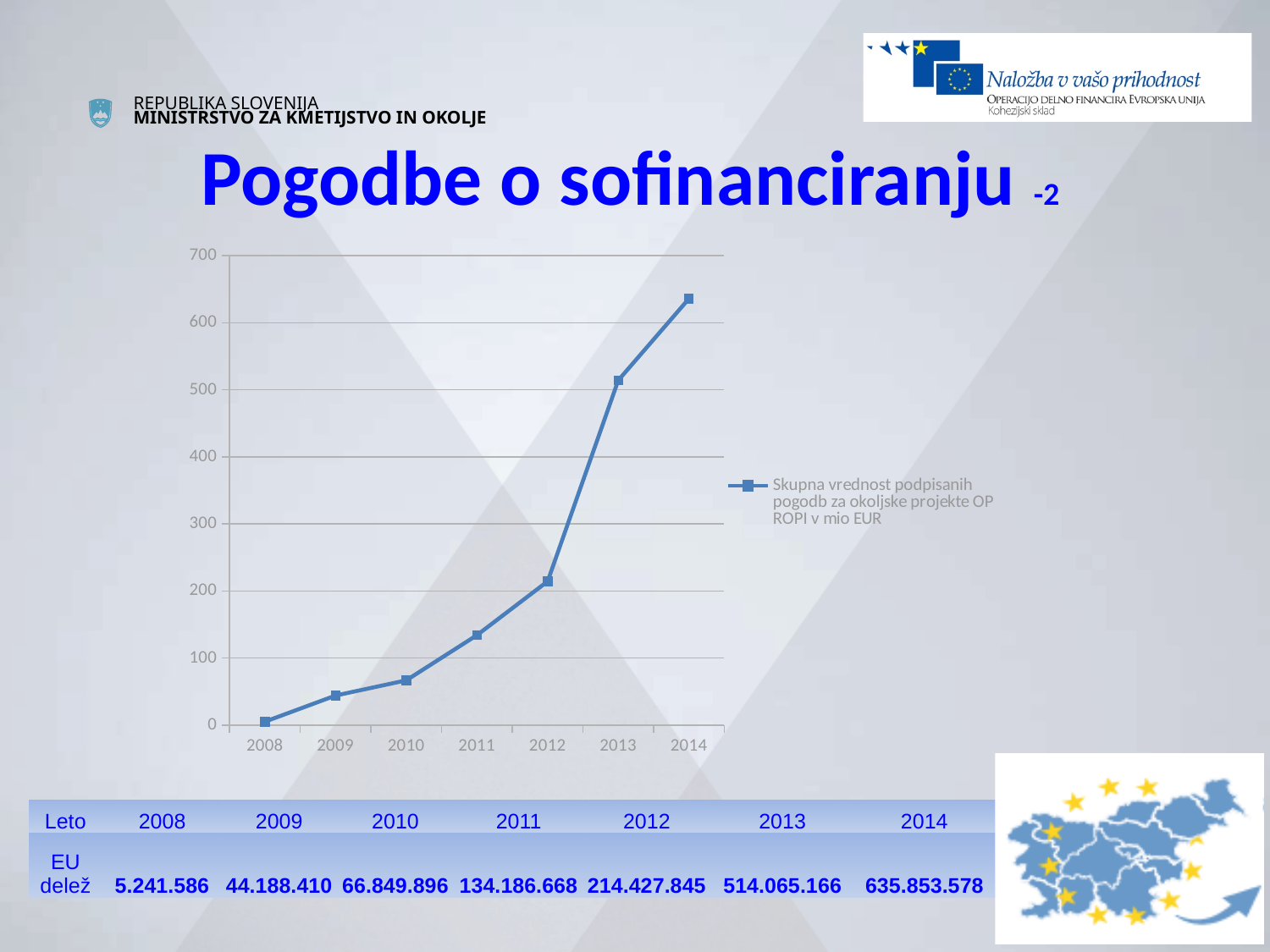
Is the value for 2010 greater or less than 100? less What kind of chart is shown on the slide? line chart How many years are plotted on the x axis of the chart? 7 Is the value for 2012 greater or less than 200? greater Which year has the lowest value in the chart? 2008 Which year has the larger value in the chart, 2011 or 2013? 2013 Which year has the highest value in the chart? 2014 Do the values in the chart rise or fall from 2008 to 2014? rise Is the value for 2013 greater or less than 500? greater What is the name of the series shown in the chart legend? Skupna vrednost podpisanih pogodb za okoljske projekte OP ROPI v mio EUR How many series does the chart legend list? 1